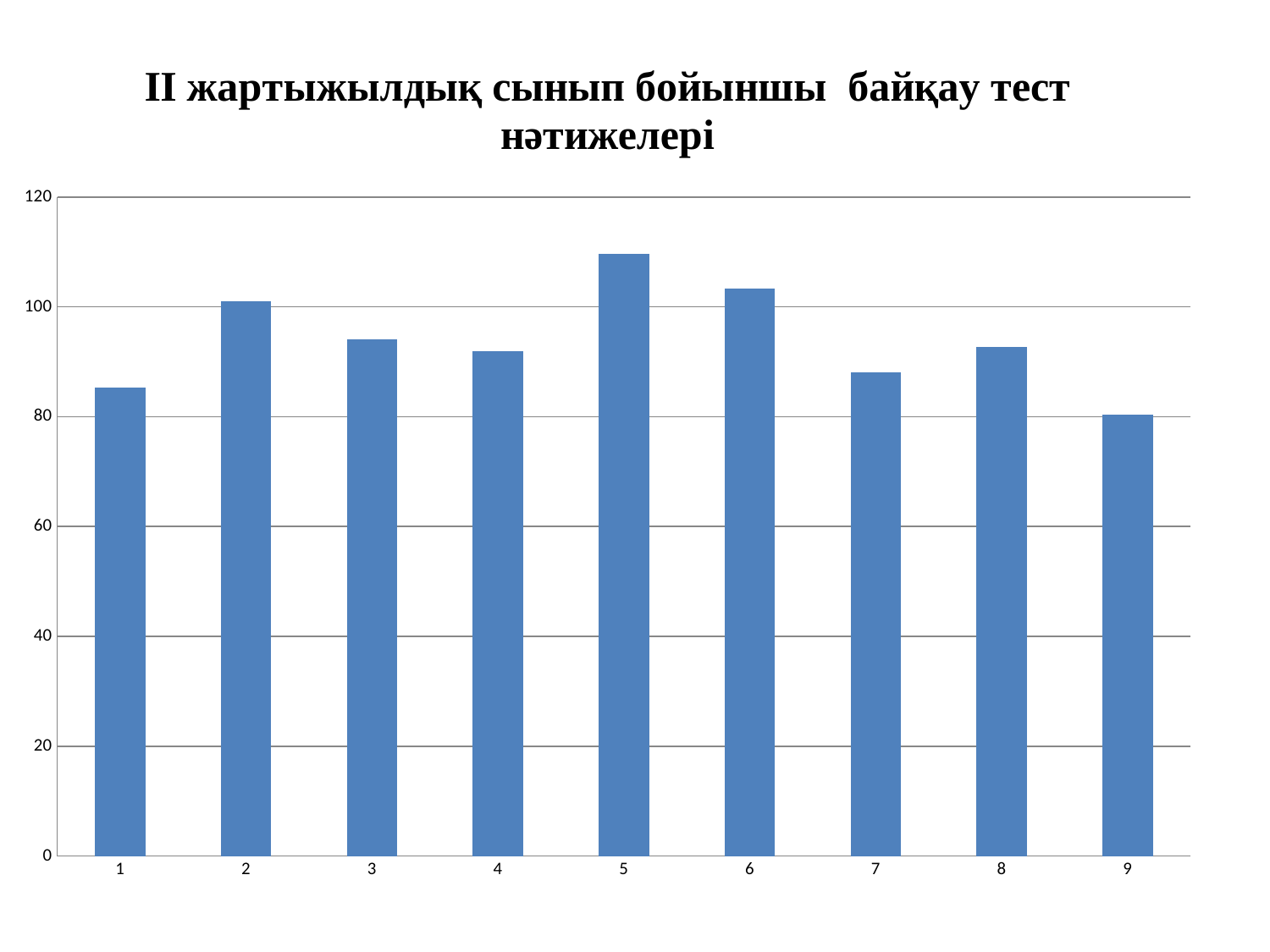
What is the title of the chart? ІІ жартыжылдық сынып бойыншы байқау тест нәтижелері Which category has the highest bar in the chart? 5 Is the value for category 9 greater or less than 60? greater Is the value for category 7 greater or less than 100? less Is the value for category 1 greater or less than 100? less What kind of chart is shown on the slide? bar chart Which is larger, the value for category 2 or the value for category 3? category 2 What is the highest value shown on the vertical axis of the chart? 120 How many categories are shown on the x axis of the chart? 9 Which category has the lowest bar in the chart? 9 Which is larger, the value for category 5 or the value for category 6? category 5